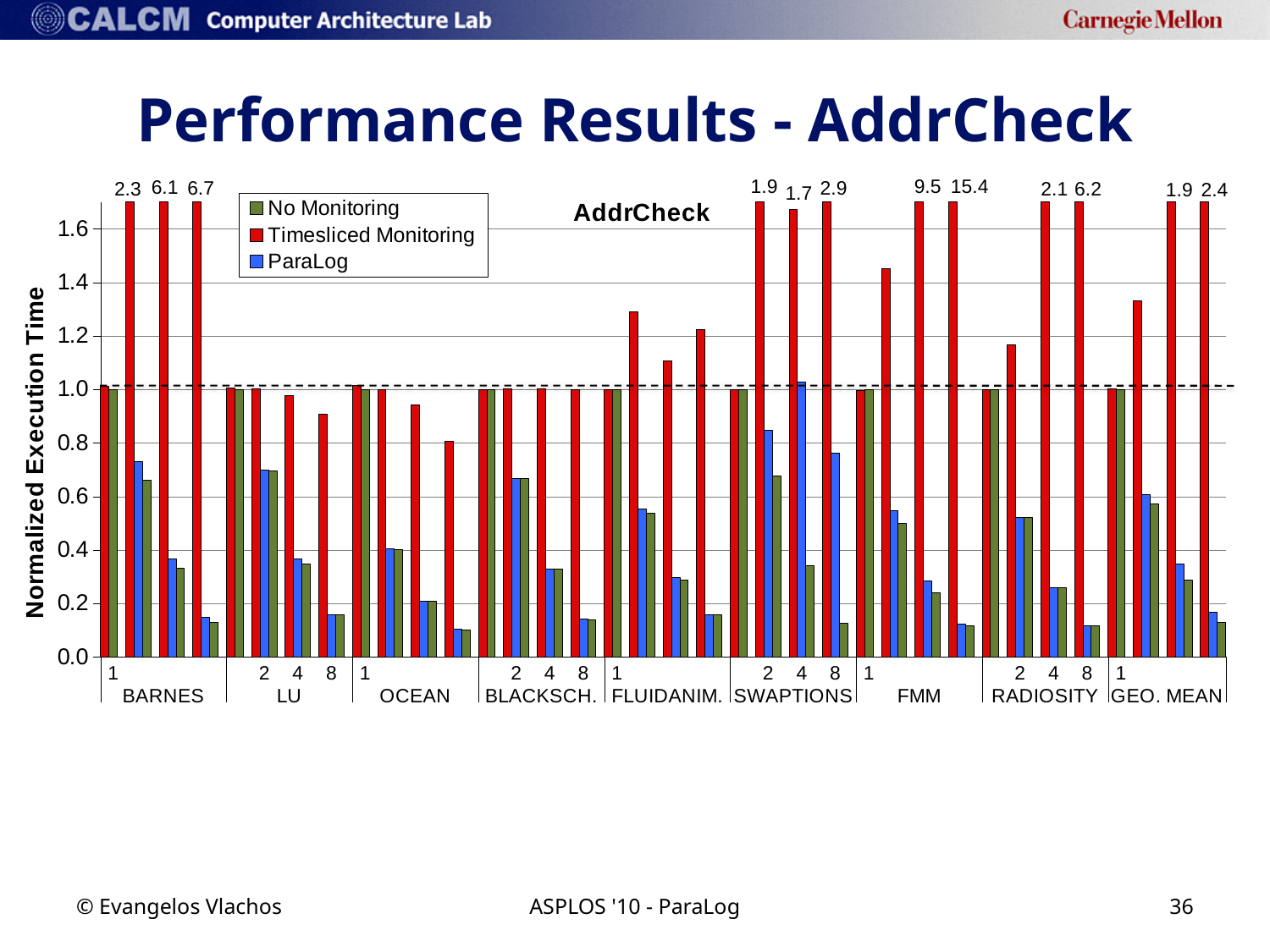
What is the difference between the Timesliced Monitoring values for BARNES at 8 threads and at 2 threads? 4.4 How many series does the legend list? 3 Which benchmark and thread count has the highest Timesliced Monitoring value? FMM with 8 threads What kind of chart is shown on the slide? bar chart What is the Timesliced Monitoring value for BARNES with 8 threads? 6.7 What is the difference between the Timesliced Monitoring values for GEO. MEAN at 8 threads and at 4 threads? 0.5 What is the Timesliced Monitoring value for FMM with 8 threads? 15.4 How many benchmark groups are shown along the x axis? 9 For SWAPTIONS, which has the larger Timesliced Monitoring value: 2 threads or 4 threads? 2 threads What are the three series named in the legend? No Monitoring, Timesliced Monitoring, ParaLog Is the ParaLog value for OCEAN with 8 threads greater or less than 0.2? less What is the Timesliced Monitoring value for RADIOSITY with 8 threads? 6.2